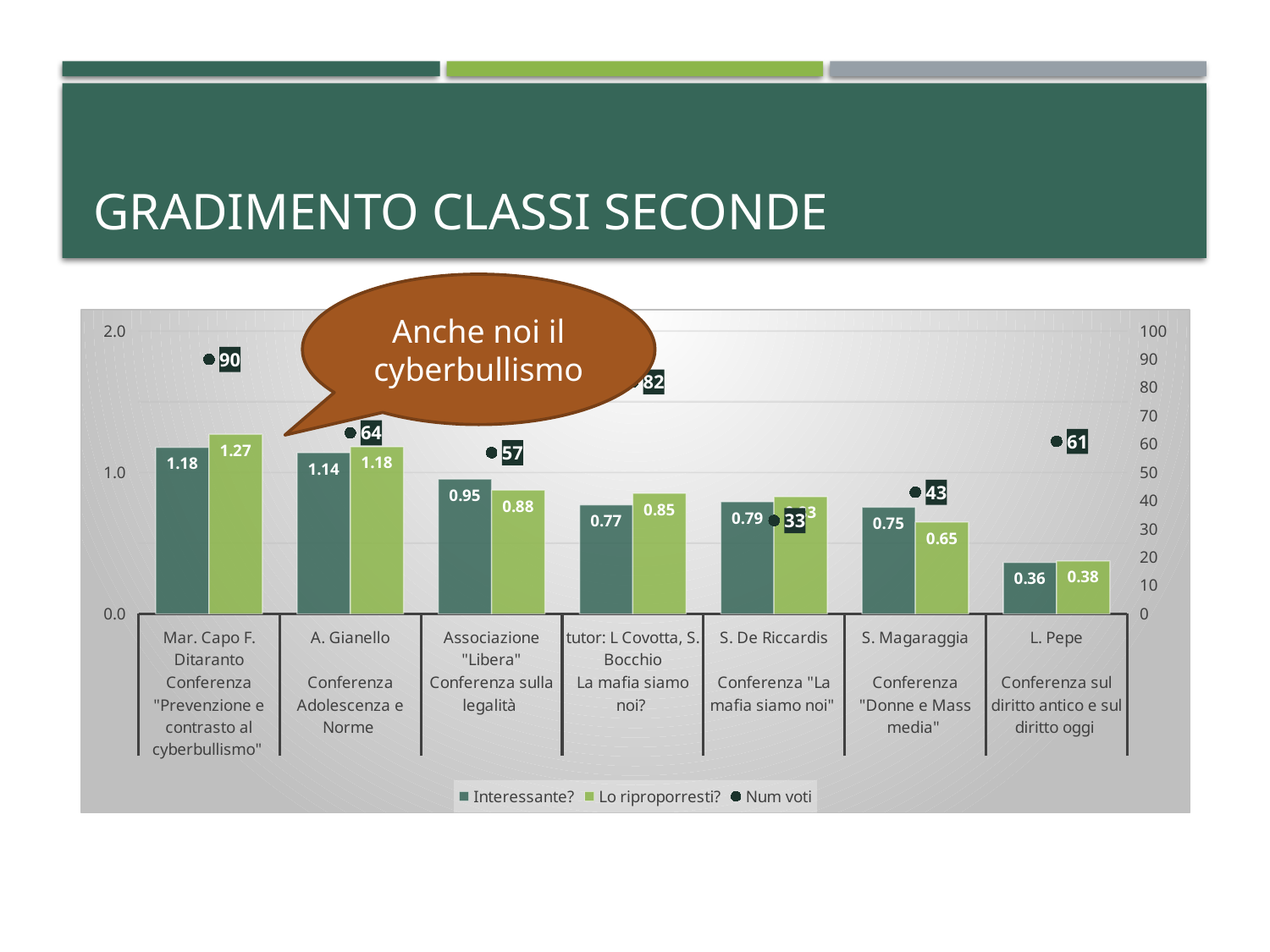
How many series does the legend list? 3 Which has the larger "Interessante?" value, Associazione "Libera" or S. De Riccardis? Associazione "Libera" Which category has the highest "Lo riproporresti?" value? Mar. Capo F. Ditaranto What is the "Interessante?" value for L. Pepe? 0.36 Is the "Num voti" value for S. De Riccardis greater or less than 50? less What is the "Lo riproporresti?" value for A. Gianello? 1.18 What kind of chart is shown on the slide? bar chart What is the difference in "Num voti" between Mar. Capo F. Ditaranto and A. Gianello? 26 How many categories are shown on the x axis? 7 Which category has the lowest "Interessante?" value? L. Pepe What is the difference between the "Lo riproporresti?" and "Interessante?" values for Mar. Capo F. Ditaranto? 0.09 What is the "Num voti" value for S. Magaraggia? 43